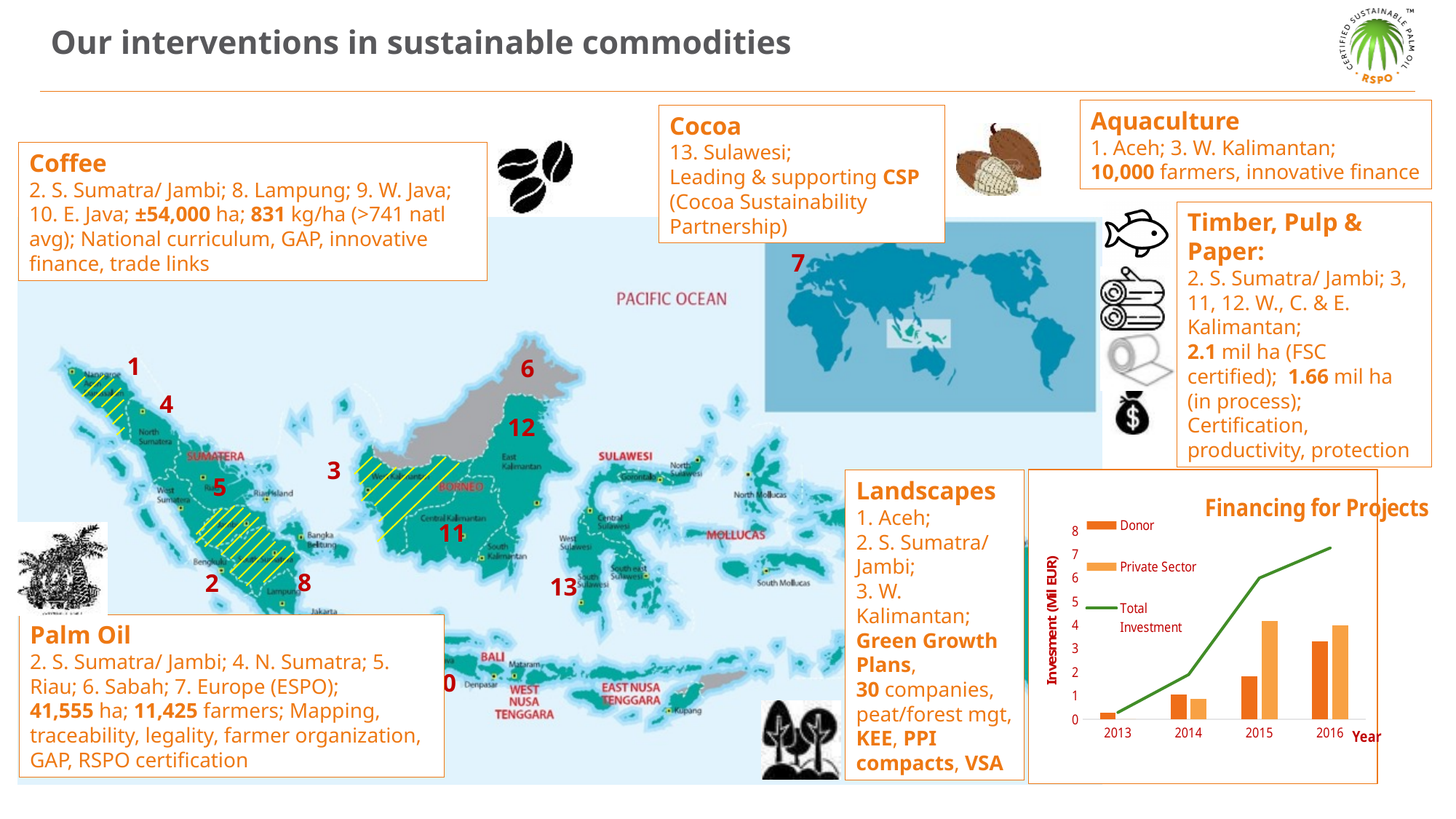
In the Financing for Projects chart, which year has the lowest Donor value? 2013 What kind of chart is the Financing for Projects chart? bar chart with a line Does the Total Investment line in the Financing for Projects chart rise or fall from 2013 to 2016? rise How many series does the legend of the Financing for Projects chart list? 3 In the Financing for Projects chart, is the Donor value for 2016 greater or less than 2? greater In the Financing for Projects chart, is the Private Sector value for 2015 greater or less than 3? greater In the Financing for Projects chart, which is larger in 2015: Donor or Private Sector? Private Sector How many years are shown on the x axis of the Financing for Projects chart? 4 What is the y-axis title of the Financing for Projects chart? Invesment (Mil EUR) In the Financing for Projects chart, which year has the highest Donor value? 2016 In the Financing for Projects chart, is the Donor value for 2014 greater or less than 2? less